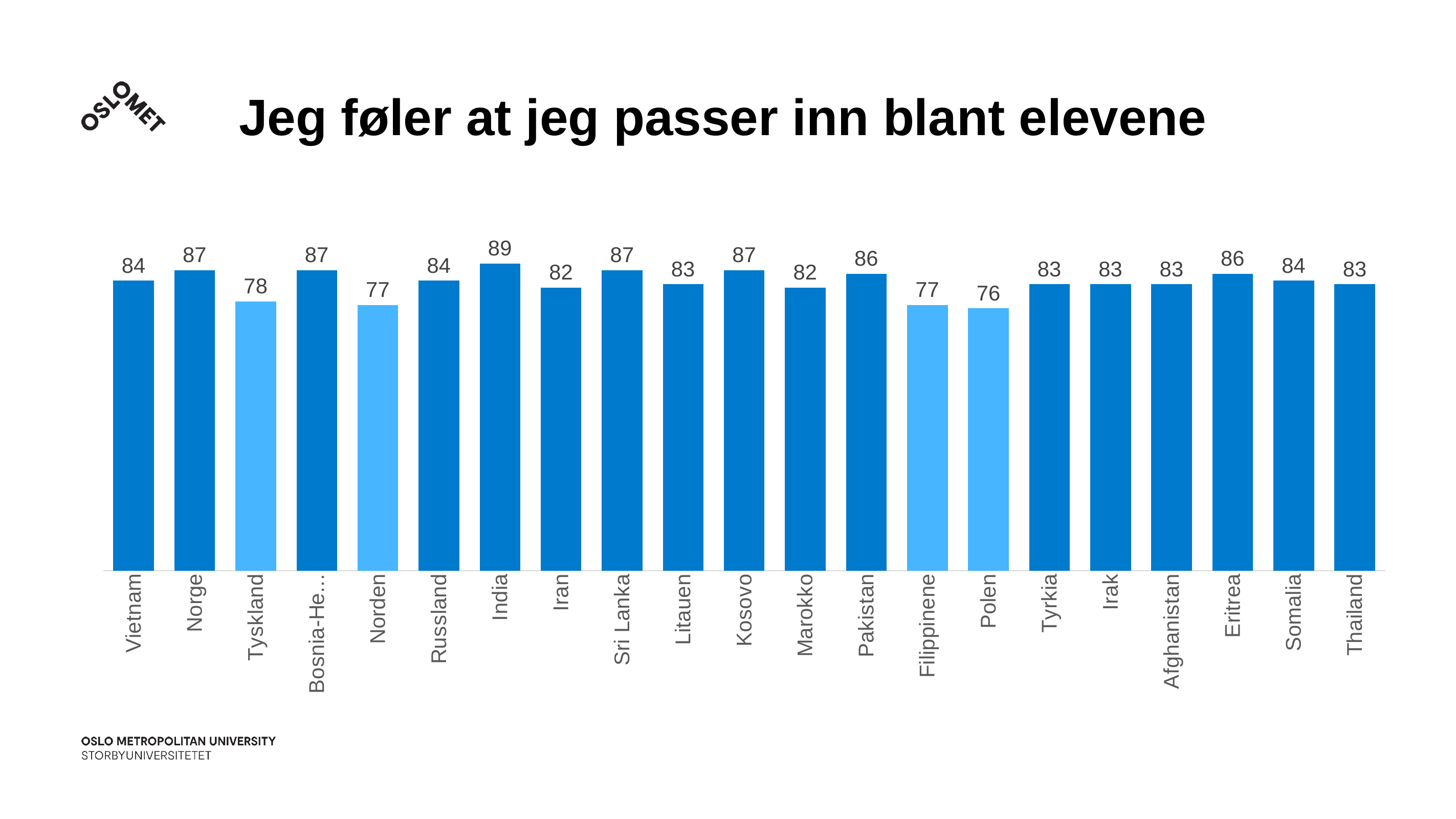
What is the value for Norden? 77 What is the difference between the values for Norge and Tyskland? 9 Which category has the lowest value? Polen What is the value for Polen? 76 What is the value for Pakistan? 86 What is the value for India? 89 Which is larger, the value for Eritrea or the value for Iran? Eritrea Which category has the highest value? India How many bars are drawn in a lighter blue than the rest? 4 What kind of chart is shown on the slide? Bar chart What is the difference between the values for India and Polen? 13 How many categories are shown on the x axis? 21